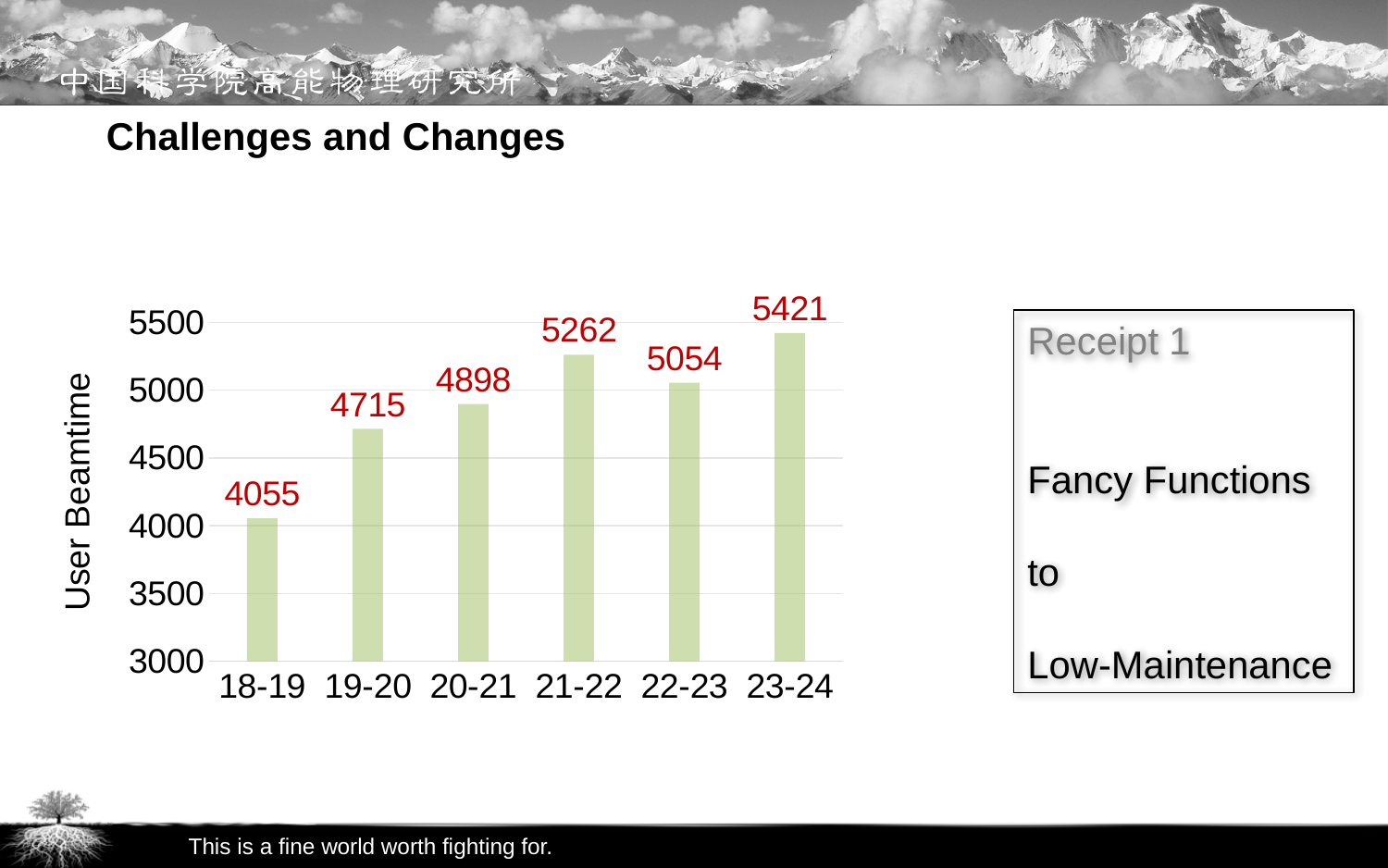
What is the difference in User Beamtime between 23-24 and 18-19? 1366 Which period has the lowest User Beamtime? 18-19 Which period has the highest User Beamtime? 23-24 What is the label of the vertical axis of the chart? User Beamtime Is the User Beamtime value for 19-20 greater or less than 5000? less What is the User Beamtime value for 18-19? 4055 How many periods are shown on the x axis of the chart? 6 What is the User Beamtime value for 21-22? 5262 Which has a larger User Beamtime, 20-21 or 22-23? 22-23 What is the User Beamtime value for 22-23? 5054 What kind of chart is shown on the slide? bar chart What is the difference in User Beamtime between 21-22 and 22-23? 208